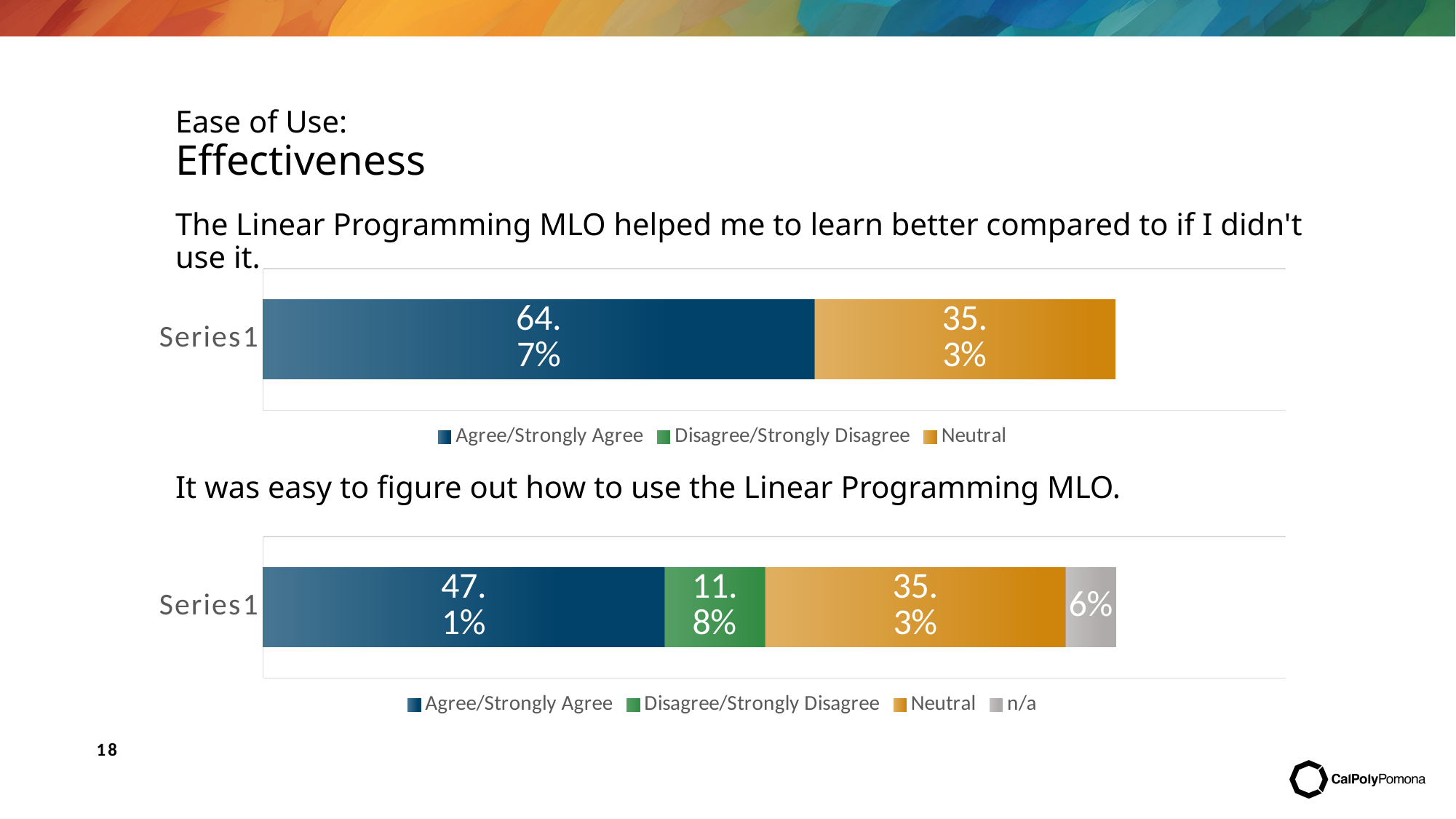
What kind of chart is used for the bottom chart ('It was easy to figure out how to use the Linear Programming MLO')? Stacked horizontal bar chart In the top chart ('The Linear Programming MLO helped me to learn better...'), what percentage is shown for Neutral? 35.3% In the top chart ('The Linear Programming MLO helped me to learn better...'), what is the difference between the Agree/Strongly Agree and Neutral percentages? 29.4% In the bottom chart ('It was easy to figure out how to use the Linear Programming MLO'), which response category has the largest share? Agree/Strongly Agree In the bottom chart ('It was easy to figure out how to use the Linear Programming MLO'), what percentage is shown for Agree/Strongly Agree? 47.1% How many entries does the legend of the top chart ('The Linear Programming MLO helped me to learn better...') list? 3 In the bottom chart ('It was easy to figure out how to use the Linear Programming MLO'), which is larger: Neutral or Disagree/Strongly Disagree? Neutral In the bottom chart ('It was easy to figure out how to use the Linear Programming MLO'), what percentage is shown for Disagree/Strongly Disagree? 11.8% In the bottom chart ('It was easy to figure out how to use the Linear Programming MLO'), which response category has the smallest share? n/a In the top chart ('The Linear Programming MLO helped me to learn better...'), what percentage is shown for Agree/Strongly Agree? 64.7% In the bottom chart ('It was easy to figure out how to use the Linear Programming MLO'), what percentage is shown for n/a? 6% How many entries does the legend of the bottom chart ('It was easy to figure out how to use the Linear Programming MLO') list? 4